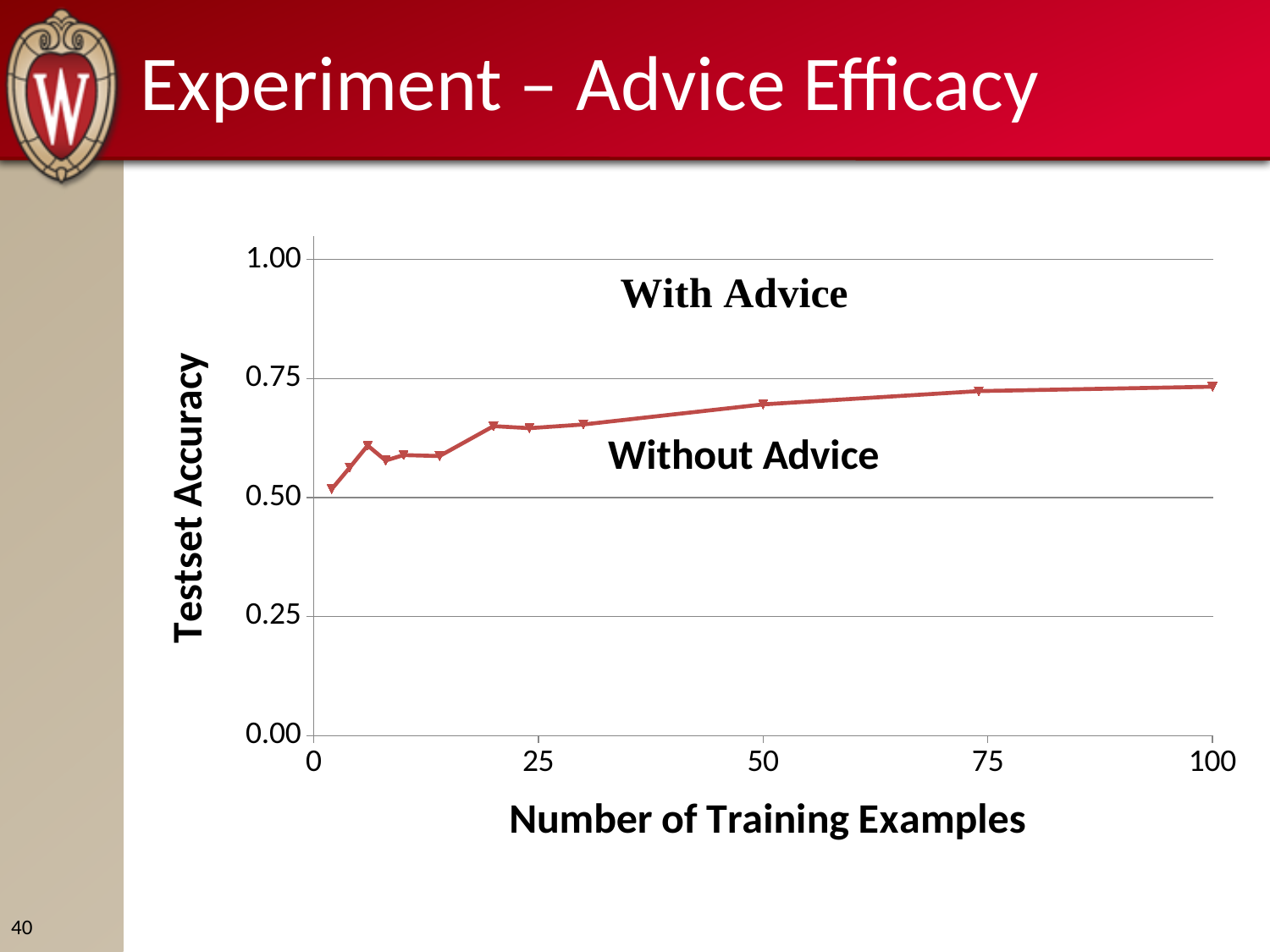
What is the highest value shown on the y axis? 1.00 Is the testset accuracy at 100 training examples greater or less than 0.50? greater What is the title of the x axis? Number of Training Examples Is the testset accuracy at 50 training examples greater or less than 0.75? less What is the title of the y axis? Testset Accuracy Does testset accuracy generally rise or fall as the number of training examples increases? rise Is the testset accuracy at the first plotted point greater or less than 0.75? less What kind of chart is shown on the slide? line chart Which has the higher testset accuracy: the point at 100 training examples or the first plotted point near 0? 100 training examples